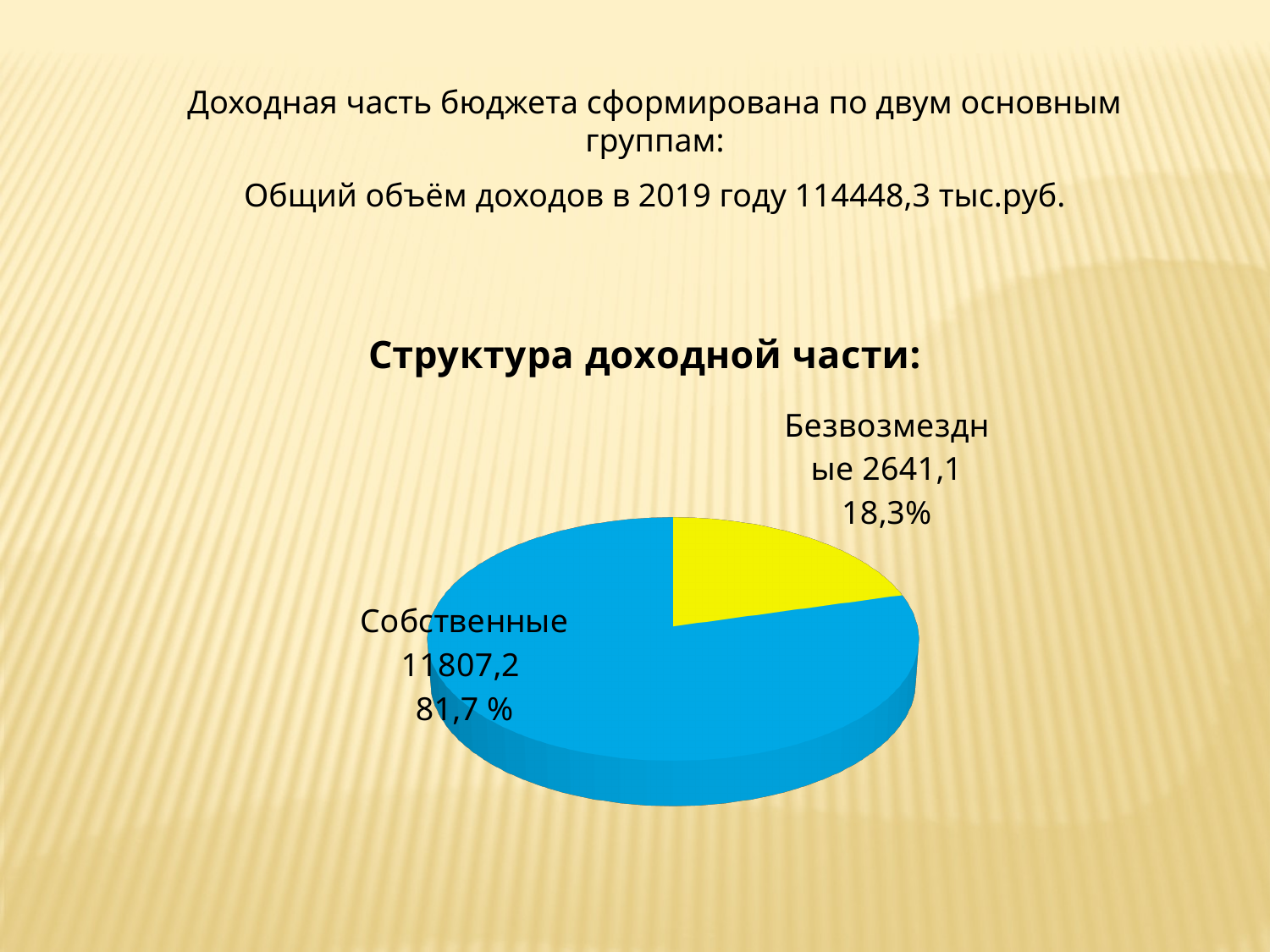
What is the value shown for Собственные? 11807,2 What kind of chart is shown on the slide? pie chart Which category has the largest slice of the pie? Собственные What is the value shown for Безвозмездные? 2641,1 Which category has the smallest slice of the pie? Безвозмездные What share of the pie does the Собственные slice represent? 81,7 % What is the title of the chart? Структура доходной части: What share of the pie does the Безвозмездные slice represent? 18,3% What colour is the Безвозмездные slice? yellow What is the difference between the values for Собственные and Безвозмездные? 9166,1 How many slices does the pie chart have? 2 Which is larger, Собственные or Безвозмездные? Собственные